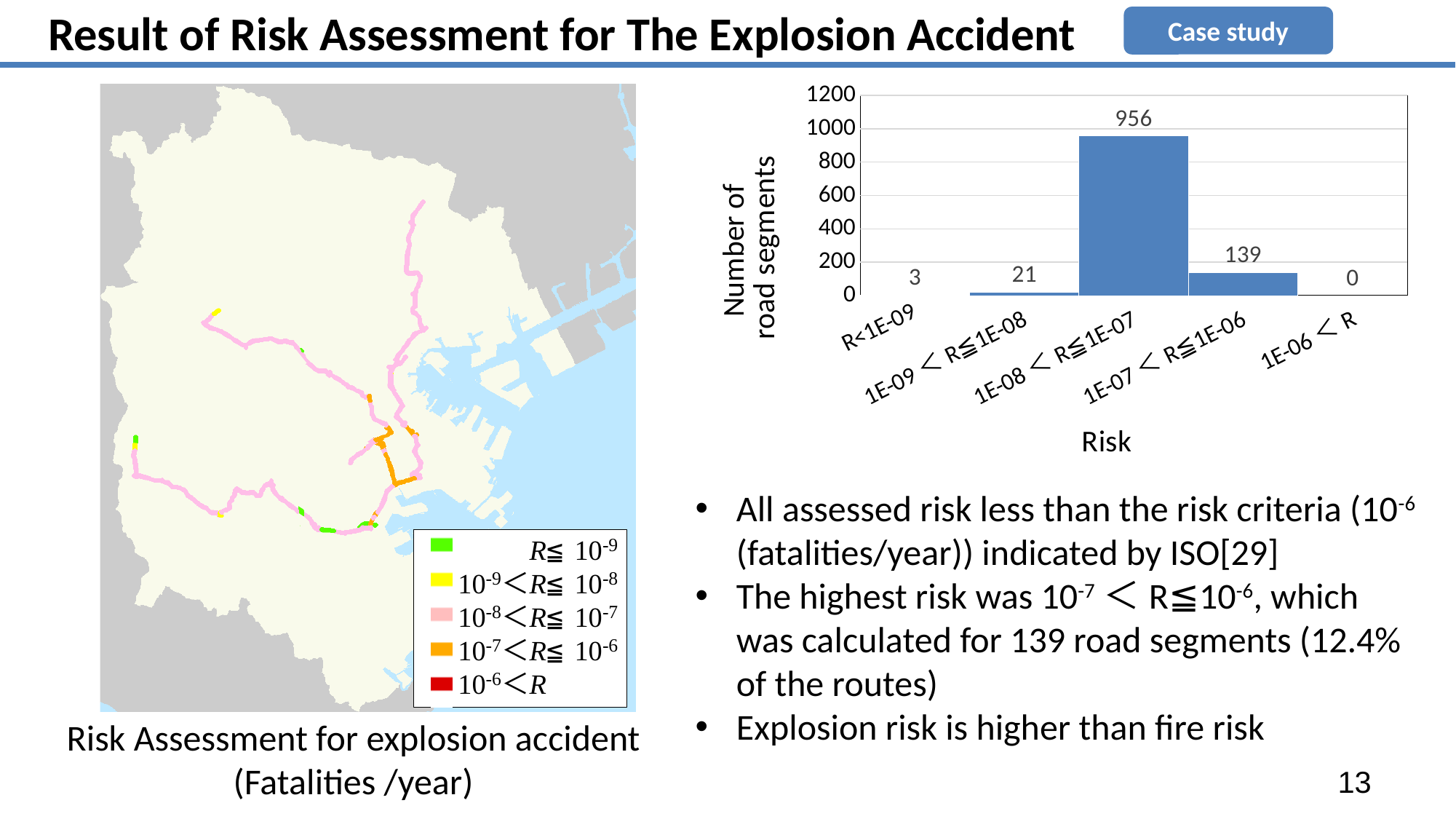
What is the x-axis label of the bar chart? Risk In the bar chart, how many road segments fall in the 1E-08 < R≦1E-07 risk category? 956 In the bar chart, what is the number of road segments for the 1E-06 < R category? 0 What is the y-axis label of the bar chart? Number of road segments How many risk categories are shown on the x axis of the bar chart? 5 Which risk category in the bar chart has the lowest number of road segments? 1E-06 < R In the bar chart, how many road segments fall in the 1E-07 < R≦1E-06 risk category? 139 In the bar chart, what is the number of road segments for the R<1E-09 category? 3 In the bar chart, what is the difference in road segments between the 1E-08 < R≦1E-07 and 1E-07 < R≦1E-06 categories? 817 In the bar chart, which has more road segments: 1E-09 < R≦1E-08 or 1E-07 < R≦1E-06? 1E-07 < R≦1E-06 Which risk category in the bar chart has the highest number of road segments? 1E-08 < R≦1E-07 What kind of chart is shown on the right side of the slide? bar chart